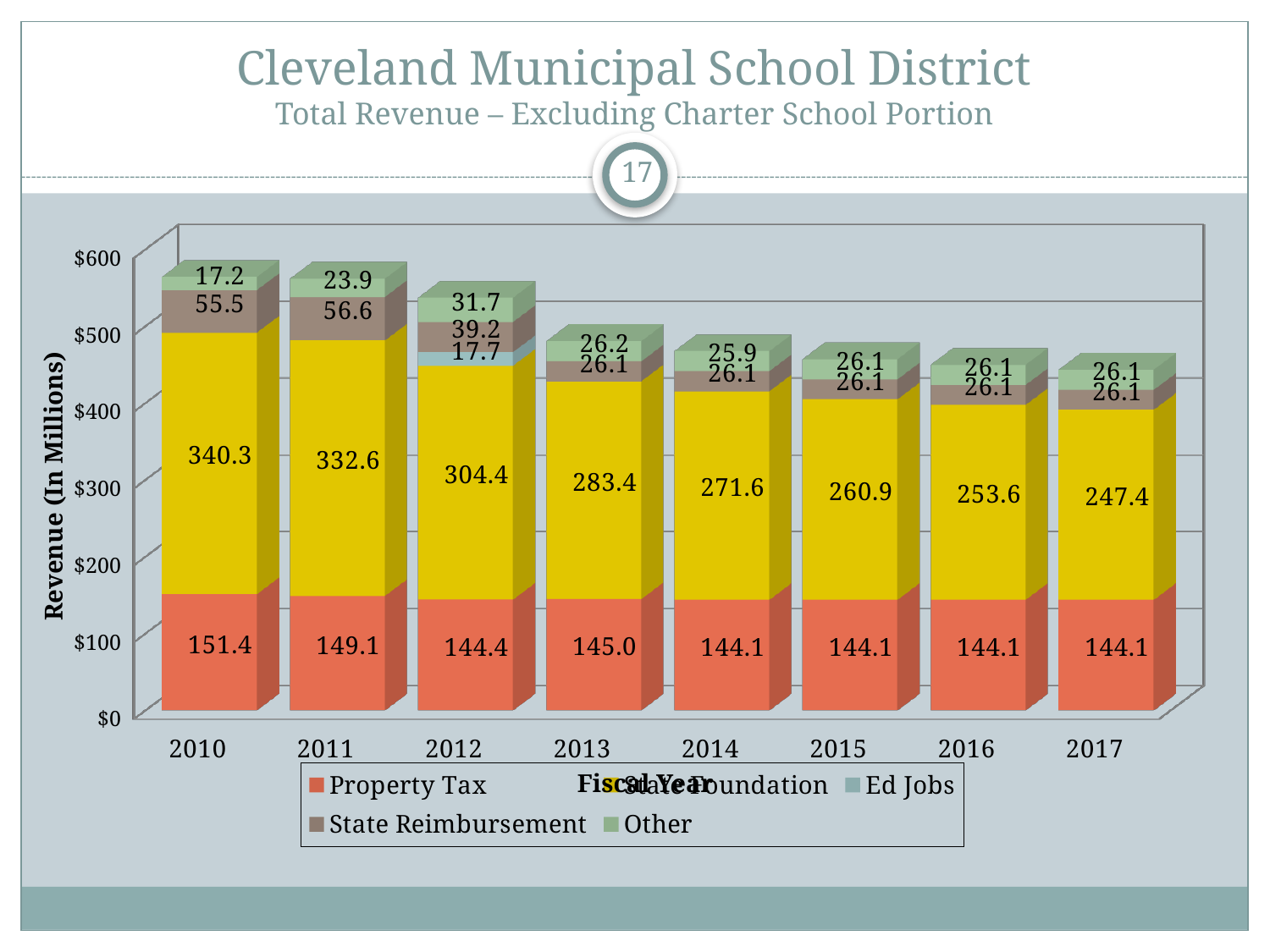
In which fiscal year is the State Foundation value highest? 2010 What kind of chart is shown on the slide? Stacked bar chart What is the Property Tax value for 2017? 144.1 How many fiscal years are shown on the x axis? 8 What is the Other value for 2012? 31.7 How many series does the legend list? 5 What is the Ed Jobs value for 2012? 17.7 What is the State Foundation value for 2010? 340.3 What is the difference between the State Foundation value in 2010 and in 2017? 92.9 Which year has the larger Property Tax value, 2010 or 2011? 2010 What is the total revenue for the 2010 bar? 564.4 In which fiscal year is the State Foundation value lowest? 2017